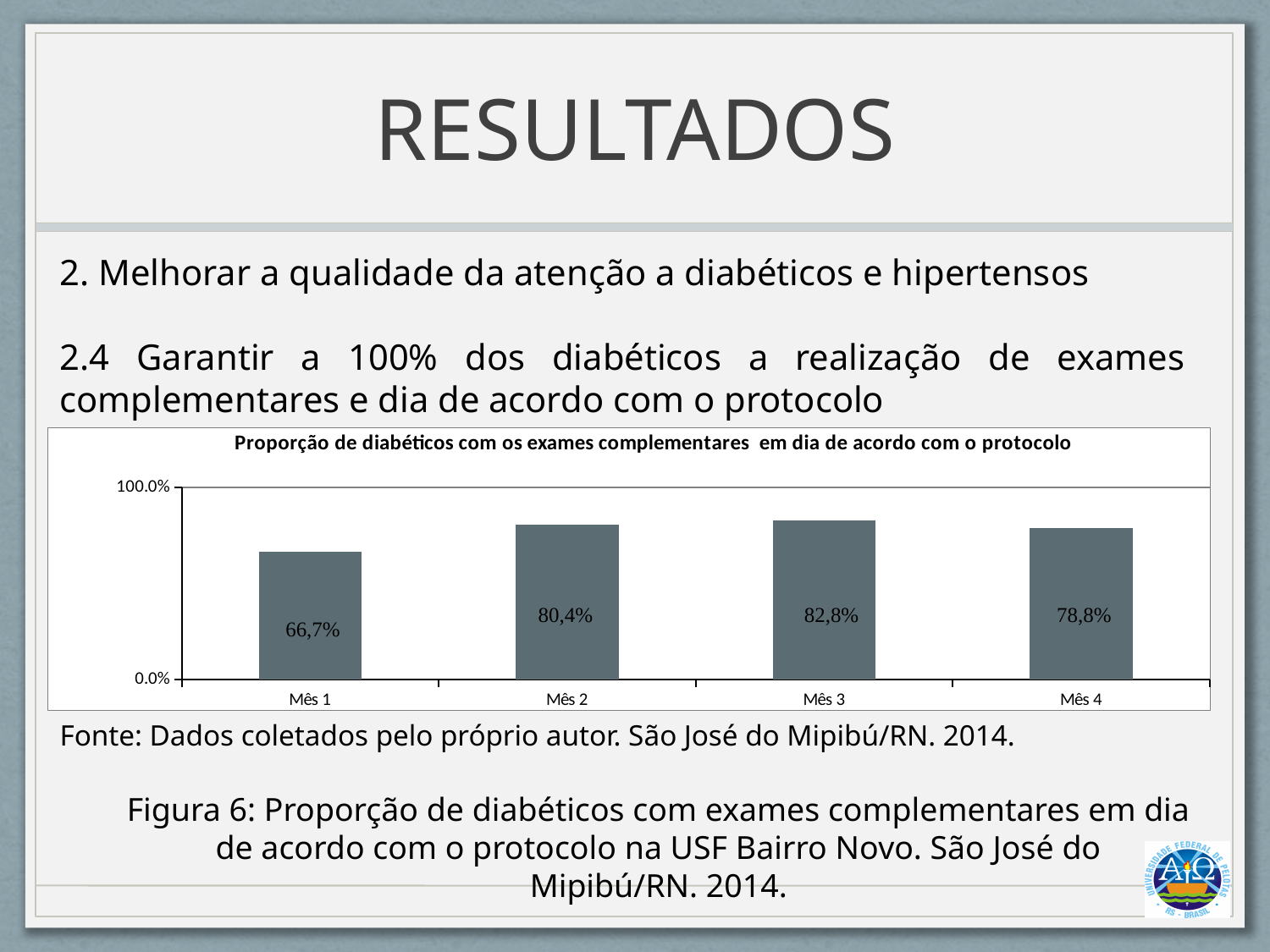
Which is larger, the value for Mês 2 or the value for Mês 4? Mês 2 What is the title of the chart? Proporção de diabéticos com os exames complementares em dia de acordo com o protocolo How many months are shown on the x axis? 4 What is the value for Mês 4? 78,8% What is the value for Mês 3? 82,8% What kind of chart is shown? bar chart Does the value rise or fall from Mês 1 to Mês 2? rise What is the value for Mês 1? 66,7% What is the difference between the values for Mês 3 and Mês 1? 16,1% Which month has the lowest proportion? Mês 1 Which month has the highest proportion? Mês 3 Is the value for Mês 2 greater or less than 100.0%? less